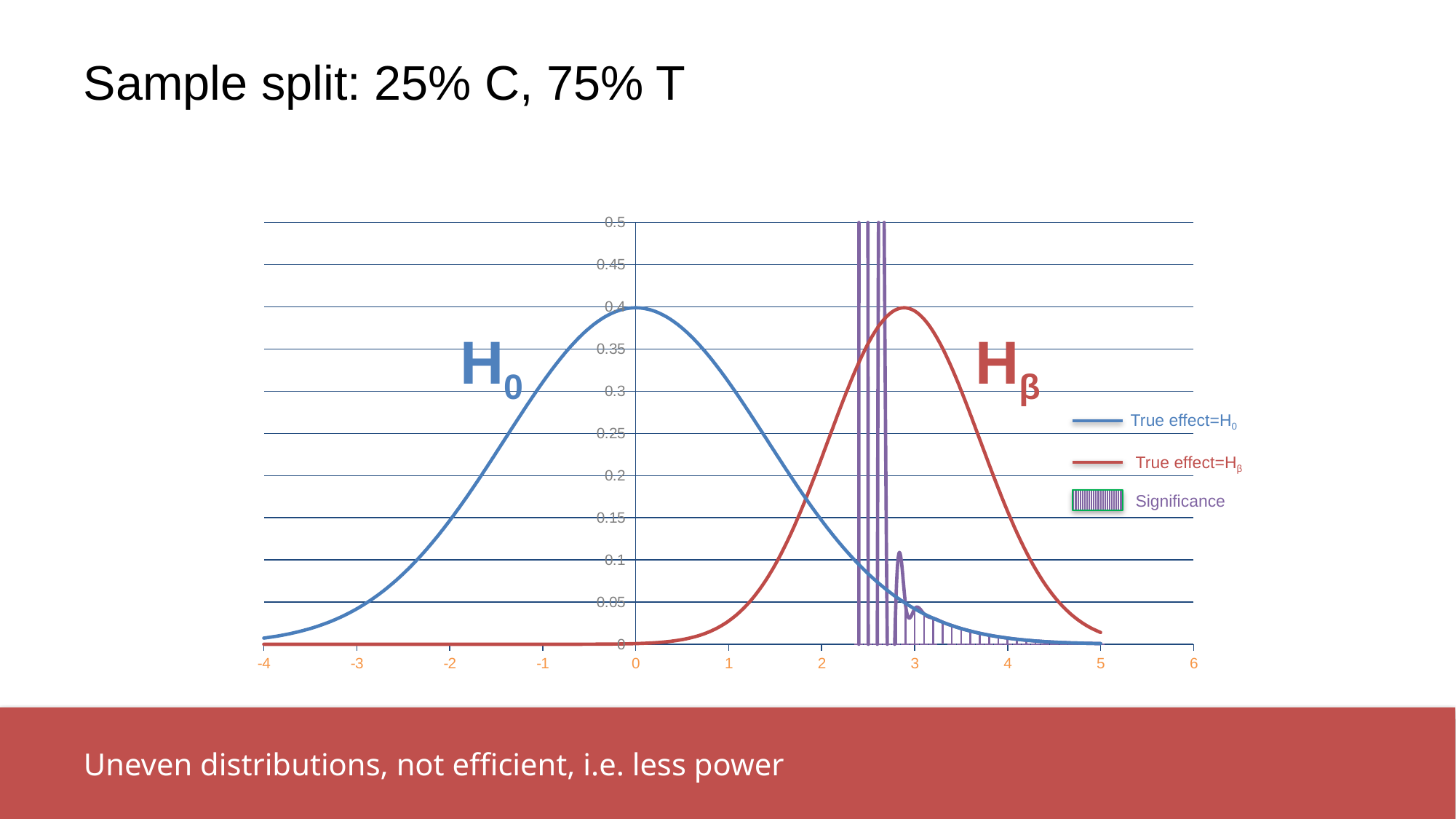
What is the title of the slide containing the chart? Sample split: 25% C, 75% T What kind of chart is shown on the slide? line chart Is the value of the Hβ curve at x = 1 greater or less than 0.1? less Which curve reaches its peak further to the right on the x axis, H0 or Hβ? Hβ How many entries does the chart legend list? 3 What colour is the curve labelled True effect=Hβ? red Is the peak value of the Hβ curve greater or less than 0.3? greater Does the Hβ curve rise or fall as x increases from 0 to 3? rise Does the H0 curve rise or fall as x increases from 0 to 5? fall Is the value of the H0 curve at x = 4 greater or less than 0.05? less